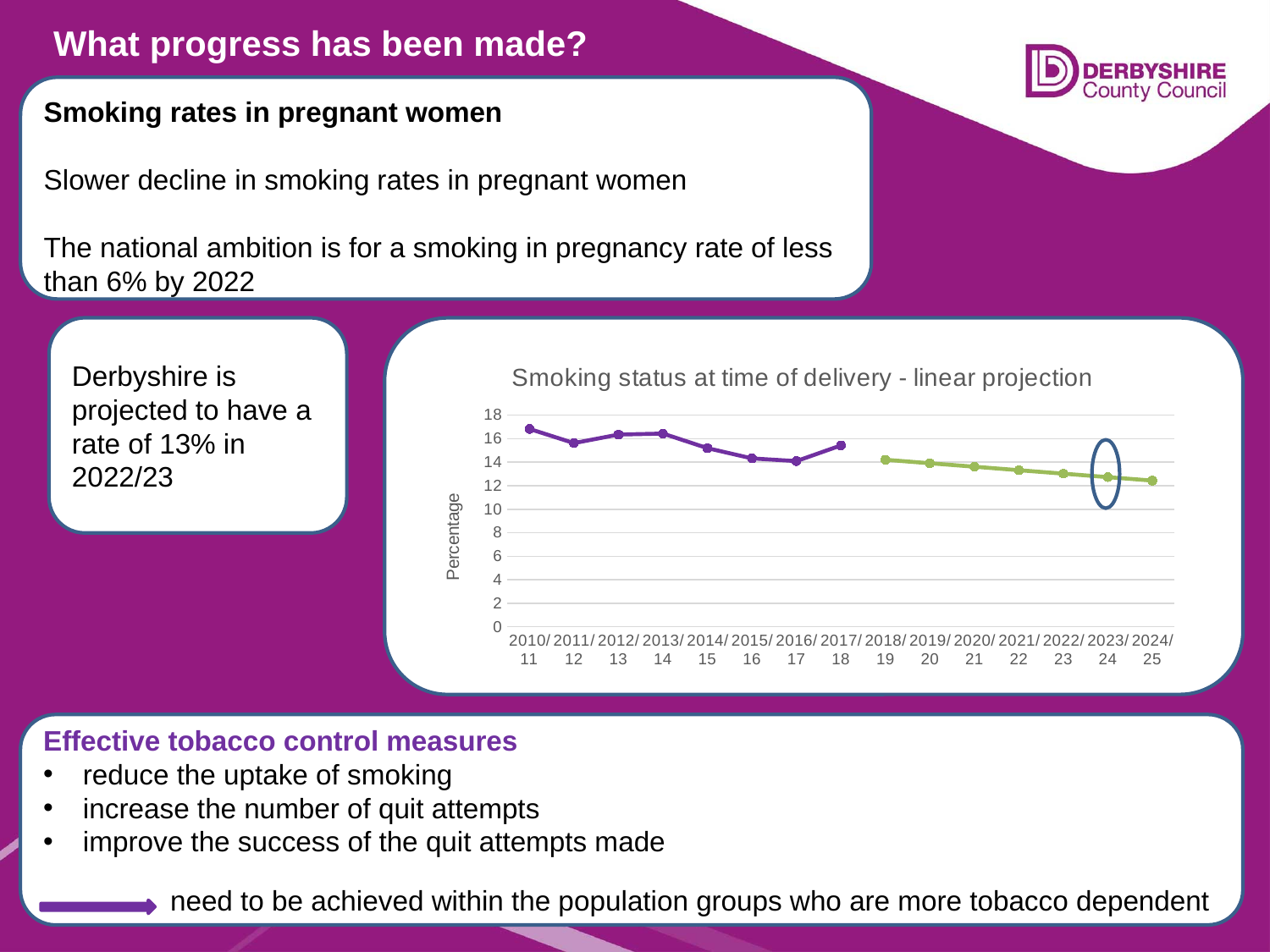
Is the value for 2024/25 greater or less than 14? less Which is larger, the value for 2010/11 or the value for 2016/17? 2010/11 Is the value for 2010/11 greater or less than 16? greater Do the values generally rise or fall from 2010/11 to 2024/25? fall Is the value for 2016/17 greater or less than 16? less What kind of chart is shown on the slide? Line chart How many time periods are shown along the x axis of the chart? 15 What is the label on the vertical axis of the chart? Percentage Which period has the highest value on the chart? 2010/11 What is the title of the chart? Smoking status at time of delivery - linear projection Which period has the lowest value on the chart? 2024/25